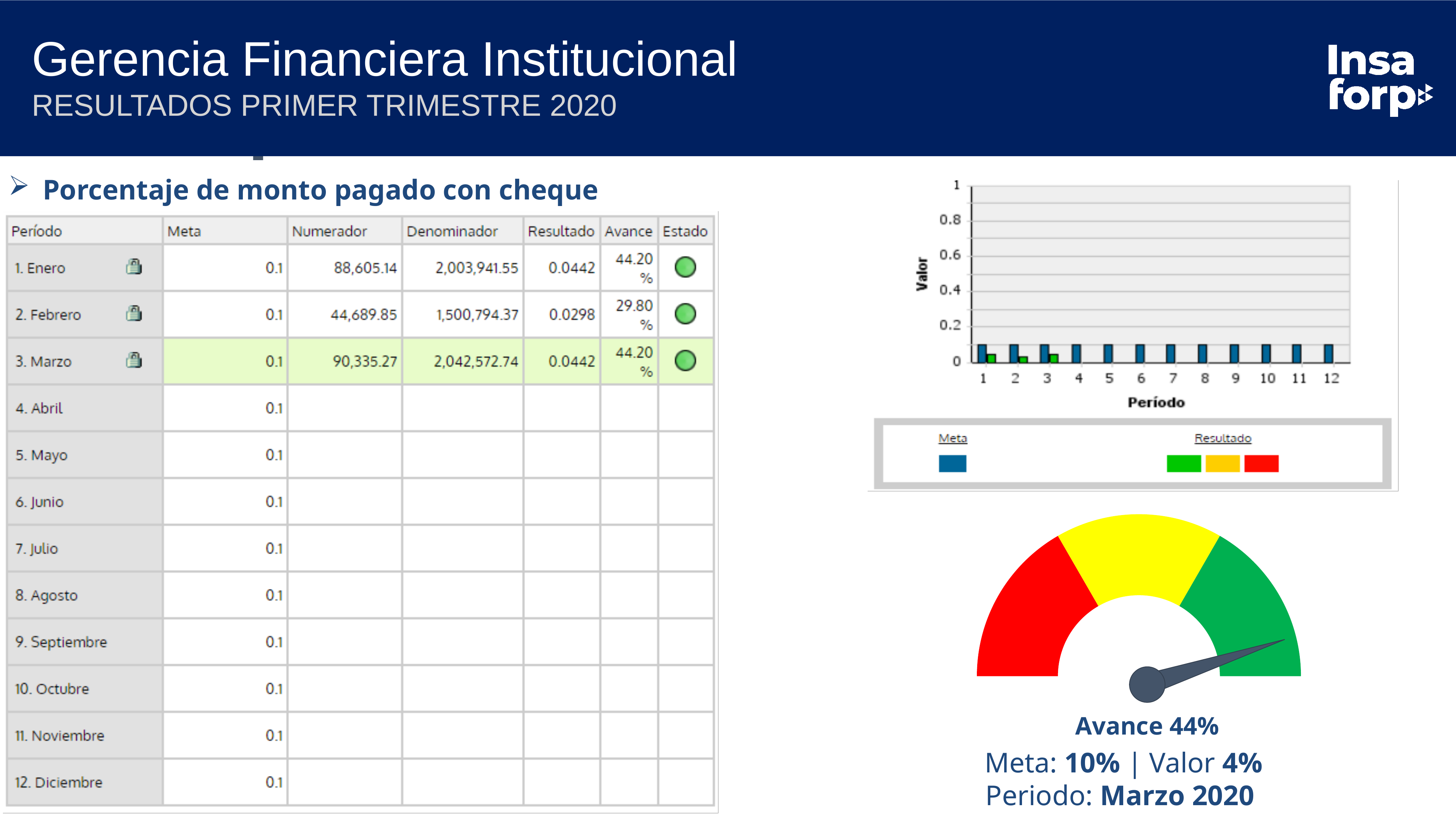
In the bar chart, how many periods have a Resultado bar plotted? 3 In the bar chart, is the Meta value for period 5 greater or less than 0.2? less In the bar chart, which is larger for period 1, the Meta bar or the Resultado bar? Meta What Avance percentage is shown below the gauge chart? 44% In the bar chart, is the Resultado value for period 1 greater or less than 0.2? less In the bar chart, how many periods are shown on the x axis? 12 In the bar chart, what are the two series named in the legend? Meta and Resultado How many series does the legend of the bar chart list? 2 What Meta value is shown below the gauge chart? 10% What Valor is shown below the gauge chart? 4% What kind of chart is the chart at the top right of the slide? bar chart In the bar chart, what is the label of the y axis? Valor